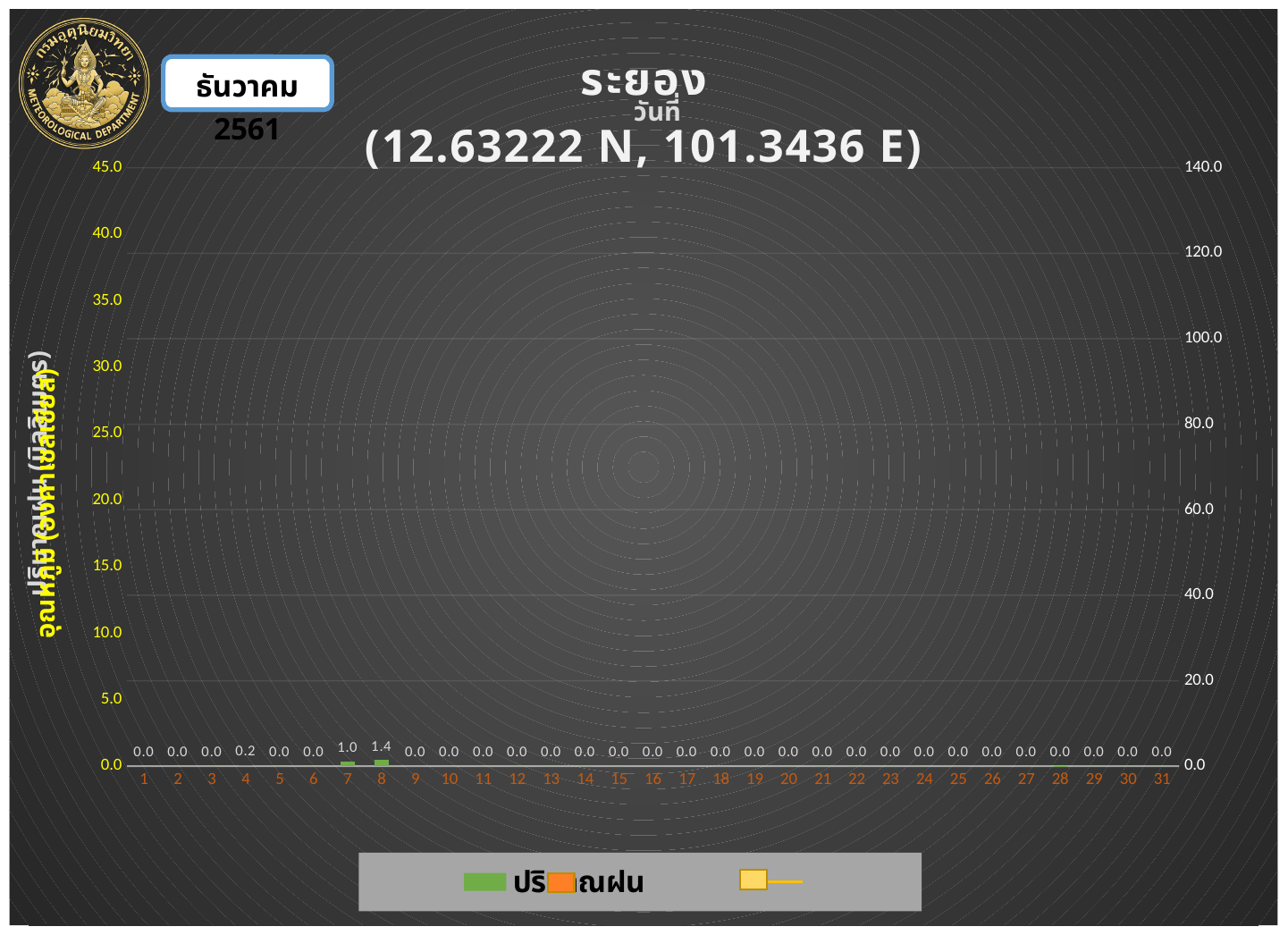
Which day has the highest rainfall value? 8 What is the difference between the rainfall values for day 8 and day 7? 0.4 What is the rainfall value shown for day 7? 1.0 How many days are shown on the x axis? 31 What is the rainfall value shown for day 8? 1.4 What kind of chart is shown on the slide? bar chart Which is larger, the rainfall value for day 4 or for day 8? day 8 What is the rainfall value shown for day 15? 0.0 What is the difference between the rainfall values for day 7 and day 4? 0.8 What is the highest tick value on the right-hand vertical axis? 140.0 What is the rainfall value shown for day 4? 0.2 How many days have a rainfall value greater than 0.0? 3